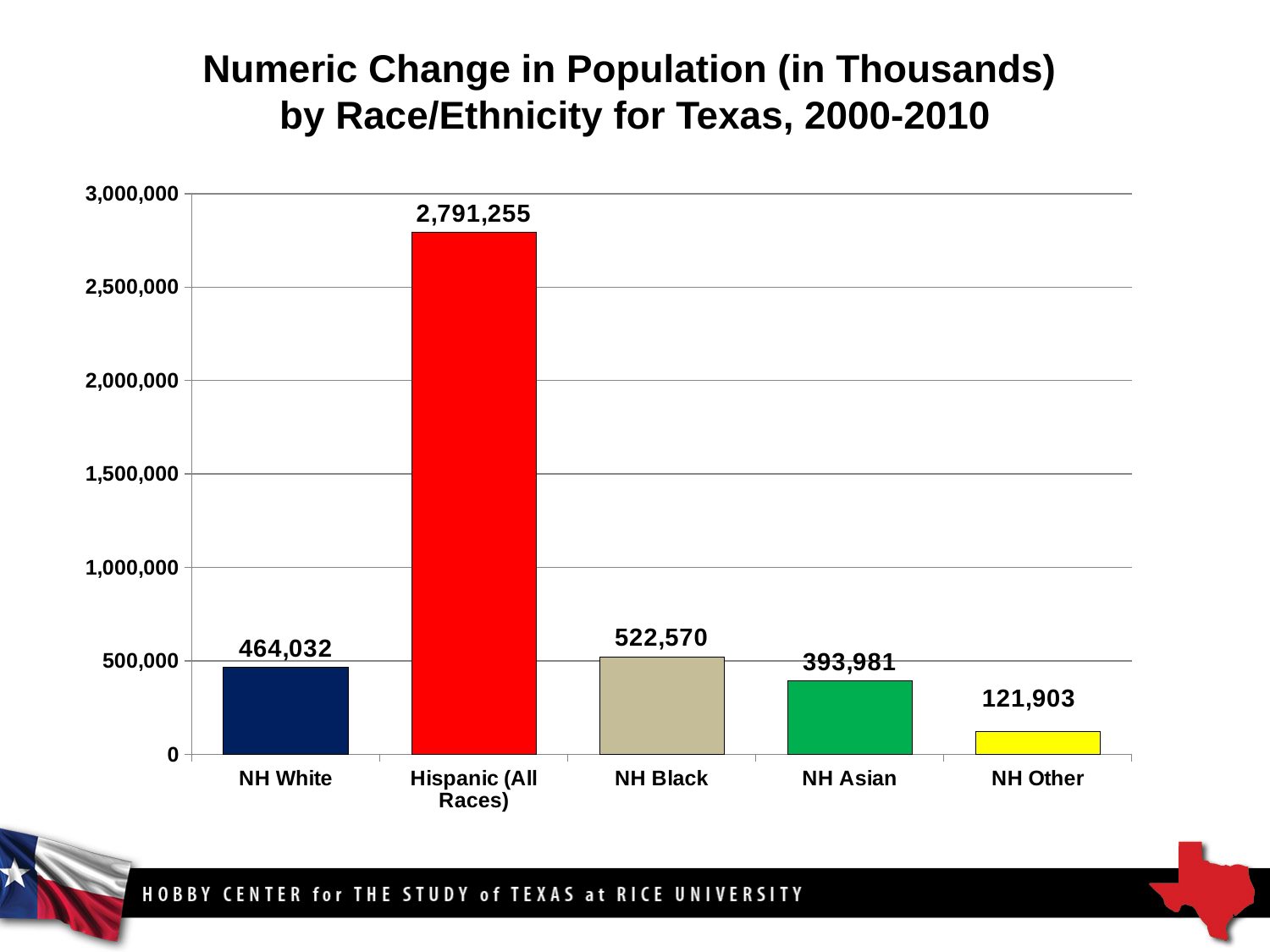
What is the difference between the values for NH Black and NH White? 58,538 Which category has the lowest value? NH Other What kind of chart is shown on the slide? Bar chart What is the value for Hispanic (All Races)? 2,791,255 What is the value for NH Asian? 393,981 Which category has the highest value? Hispanic (All Races) What is the value for NH White? 464,032 What is the value for NH Black? 522,570 What is the value for NH Other? 121,903 How many categories are shown on the x axis? 5 What is the title of the chart? Numeric Change in Population (in Thousands) by Race/Ethnicity for Texas, 2000-2010 Which is larger, the value for NH White or the value for NH Asian? NH White